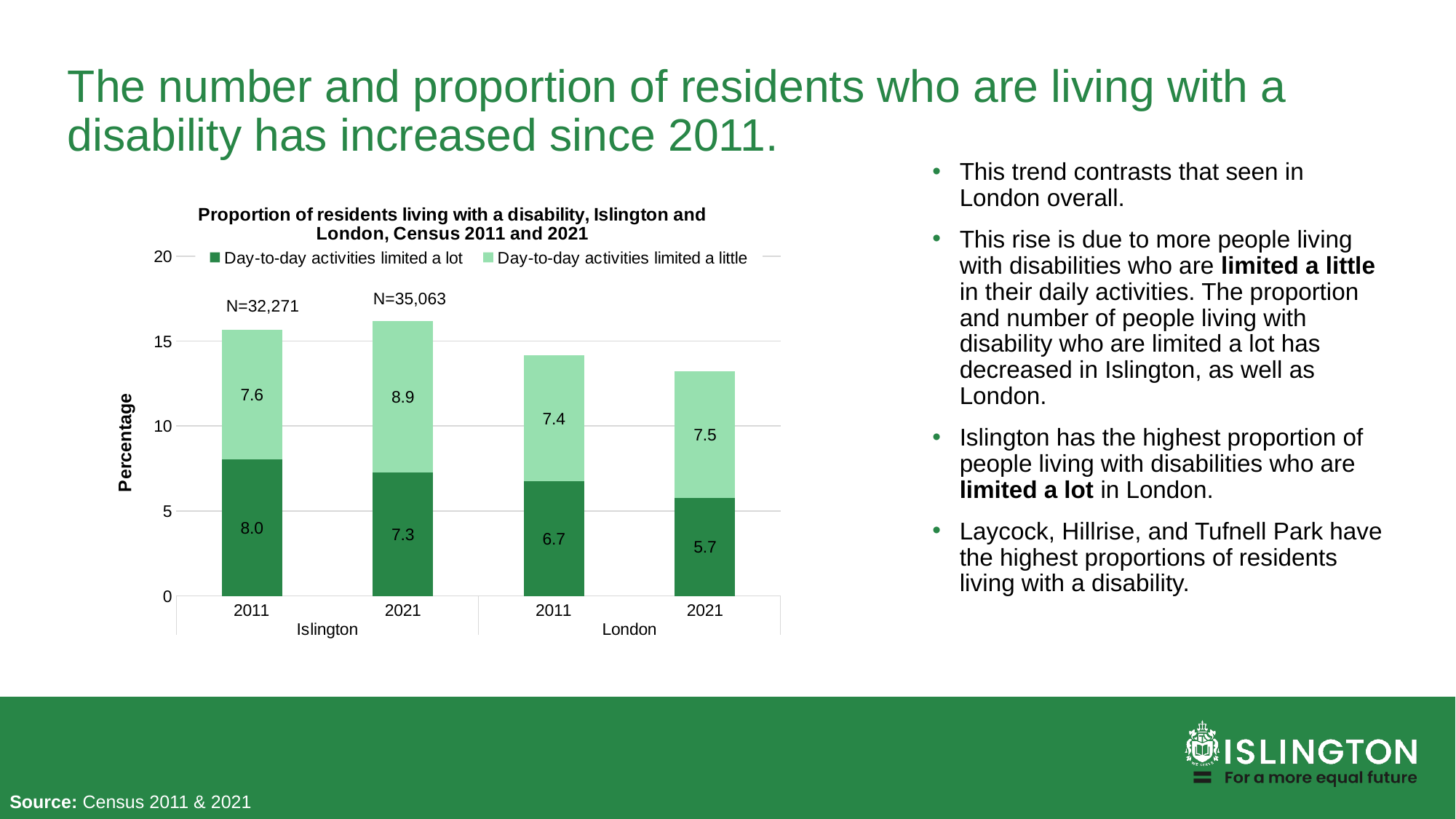
What is the value for 'Day-to-day activities limited a lot' for Islington in 2011? 8.0 What is the difference between the 'limited a lot' values for Islington in 2011 and 2021? 0.7 What is the value for 'Day-to-day activities limited a little' for London in 2021? 7.5 Which is larger: the 'limited a little' value for Islington in 2021 or for London in 2021? Islington 2021 Which bar has the highest value for 'Day-to-day activities limited a lot'? Islington 2011 How many series does the legend list? 2 What kind of chart is shown on the slide? Stacked bar chart Which bar has the lowest value for 'Day-to-day activities limited a lot'? London 2021 What is the total of the stacked bar for Islington in 2021? 16.2 What is the N value shown above the Islington 2021 bar? N=35,063 What is the total of the stacked bar for London in 2011? 14.1 What is the value for 'Day-to-day activities limited a little' for Islington in 2021? 8.9